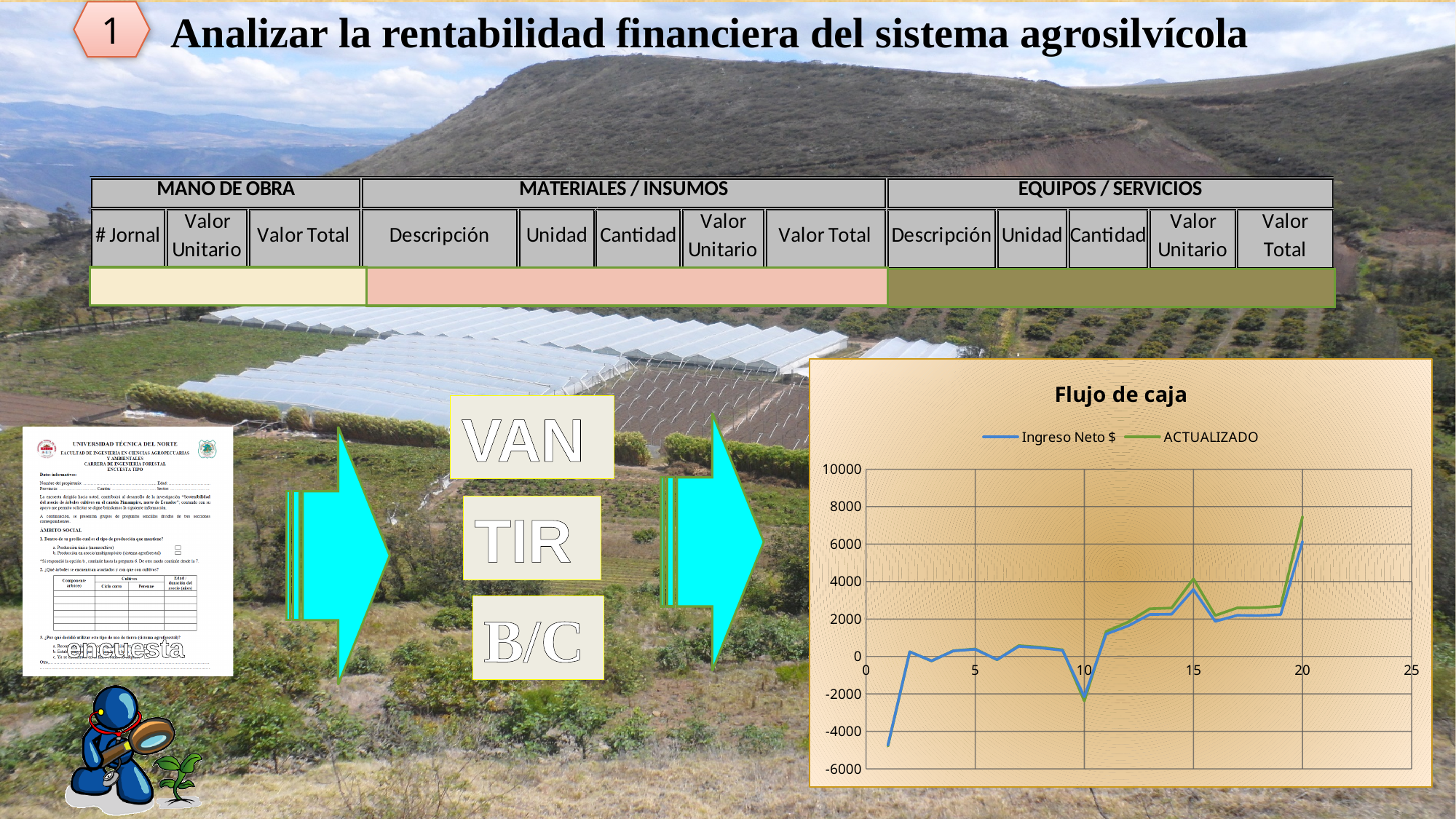
In the 'Flujo de caja' chart, which series is higher at x = 20, Ingreso Neto $ or ACTUALIZADO? ACTUALIZADO Which two series are listed in the legend of the 'Flujo de caja' chart? Ingreso Neto $ and ACTUALIZADO In the 'Flujo de caja' chart, at which x value does the Ingreso Neto $ series reach its lowest point? 1 In the 'Flujo de caja' chart, is the Ingreso Neto $ value at x = 10 greater or less than 0? less How many series does the legend of the 'Flujo de caja' chart list? 2 In the 'Flujo de caja' chart, is the Ingreso Neto $ value at x = 5 greater or less than 2000? less What kind of chart is 'Flujo de caja'? line chart In the 'Flujo de caja' chart, is the Ingreso Neto $ value at x = 1 greater or less than -4000? less What is the title of the chart on the slide? Flujo de caja In the 'Flujo de caja' chart, at which x value does the ACTUALIZADO series reach its highest point? 20